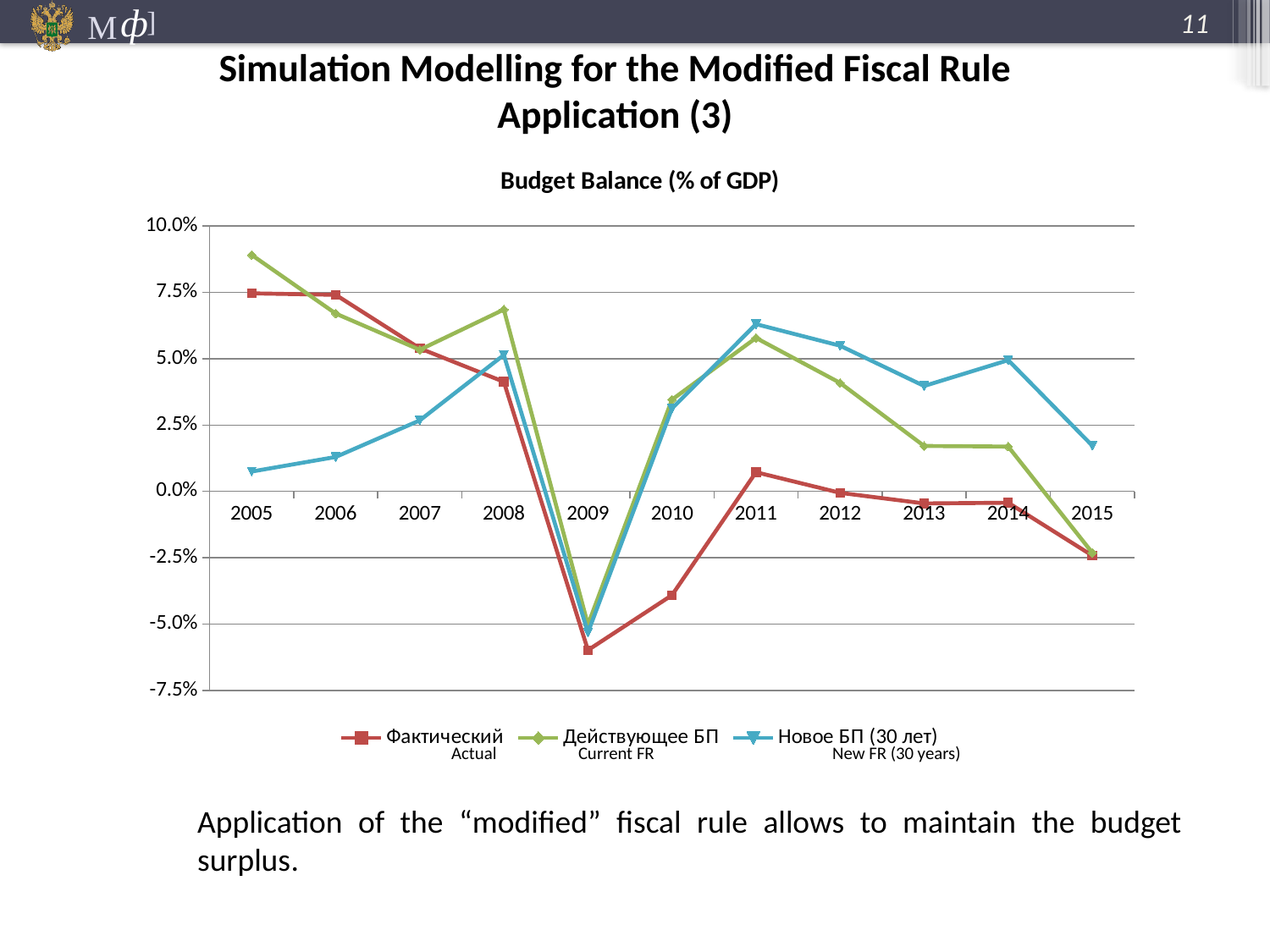
In 2005, which series has the higher value: Actual (Фактический) or Current FR (Действующее БП)? Current FR (Действующее БП) What is the title of the chart? Budget Balance (% of GDP) Is the value for the New FR (30 years) series in 2011 greater or less than 5.0%? greater What kind of chart is shown on the slide? line chart How many years are plotted along the x axis? 11 Does the New FR (30 years) series rise or fall from 2005 to 2008? rise Is the value for the Current FR (Действующее БП) series in 2005 greater or less than 7.5%? greater Is the value for the Actual (Фактический) series in 2009 greater or less than -5.0%? less How many series does the legend list? 3 In which year does the Actual (Фактический) series reach its lowest value? 2009 In 2015, which series has the higher value: New FR (30 years) or Current FR (Действующее БП)? New FR (30 years)